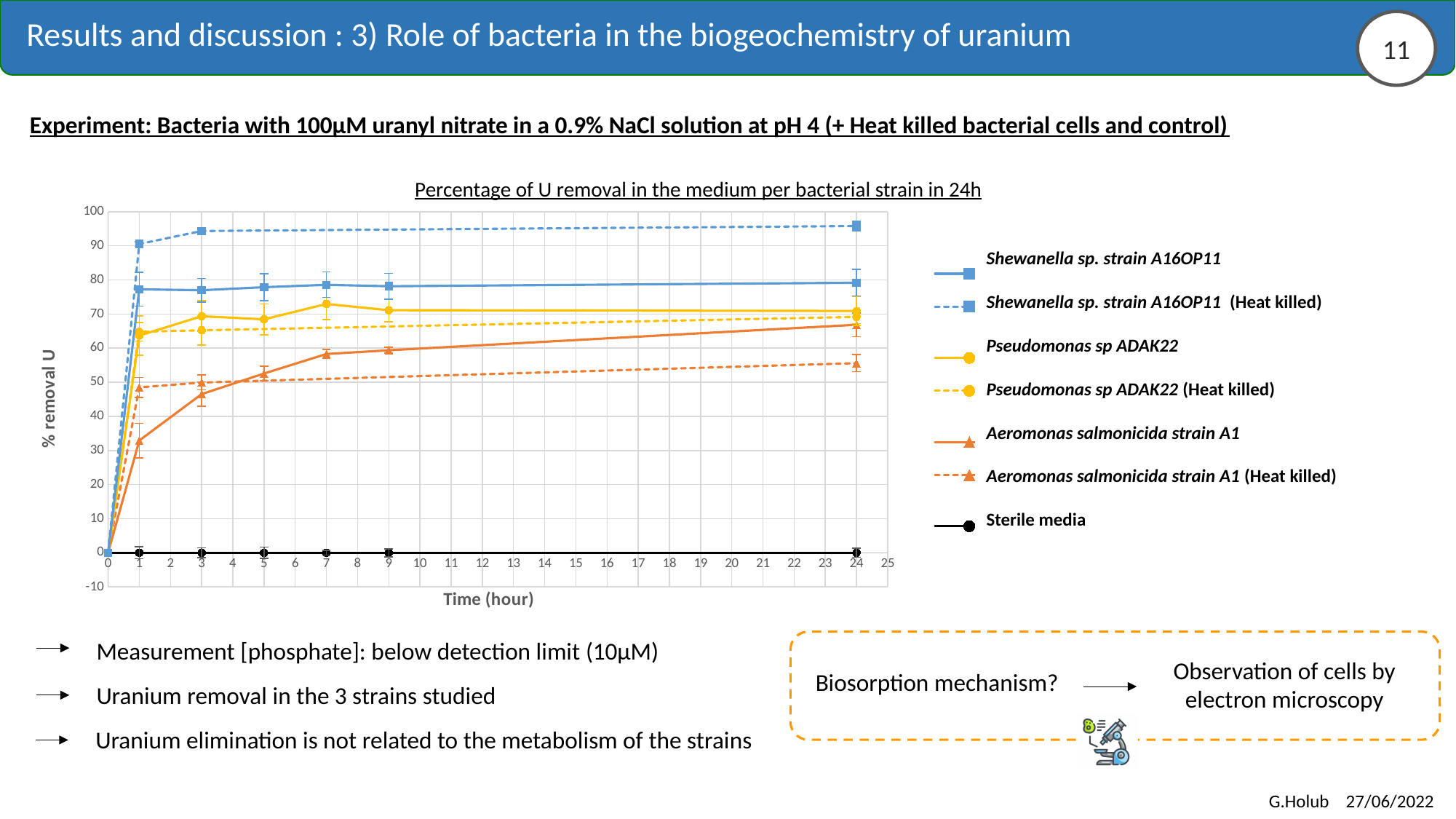
What is the title of the chart? Percentage of U removal in the medium per bacterial strain in 24h At 24 hours, which has a higher % removal U: Shewanella sp. strain A16OP11 (Heat killed) or Pseudomonas sp ADAK22? Shewanella sp. strain A16OP11 (Heat killed) What is the label of the x axis of the chart? Time (hour) Does the % removal U for Aeromonas salmonicida strain A1 rise or fall between 1 hour and 24 hours? rise Is the % removal U for Aeromonas salmonicida strain A1 (Heat killed) at 24 hours greater or less than 50? greater Is the % removal U for Shewanella sp. strain A16OP11 (Heat killed) at 24 hours greater or less than 90? greater How many series does the chart legend list? 7 Which series has the lowest % removal U across the whole time course? Sterile media What is the % removal U for Sterile media at 24 hours? 0 What kind of chart is shown on the slide? line chart Is the % removal U for Aeromonas salmonicida strain A1 at 1 hour greater or less than 40? less Which series has the highest % removal U at 24 hours? Shewanella sp. strain A16OP11 (Heat killed)